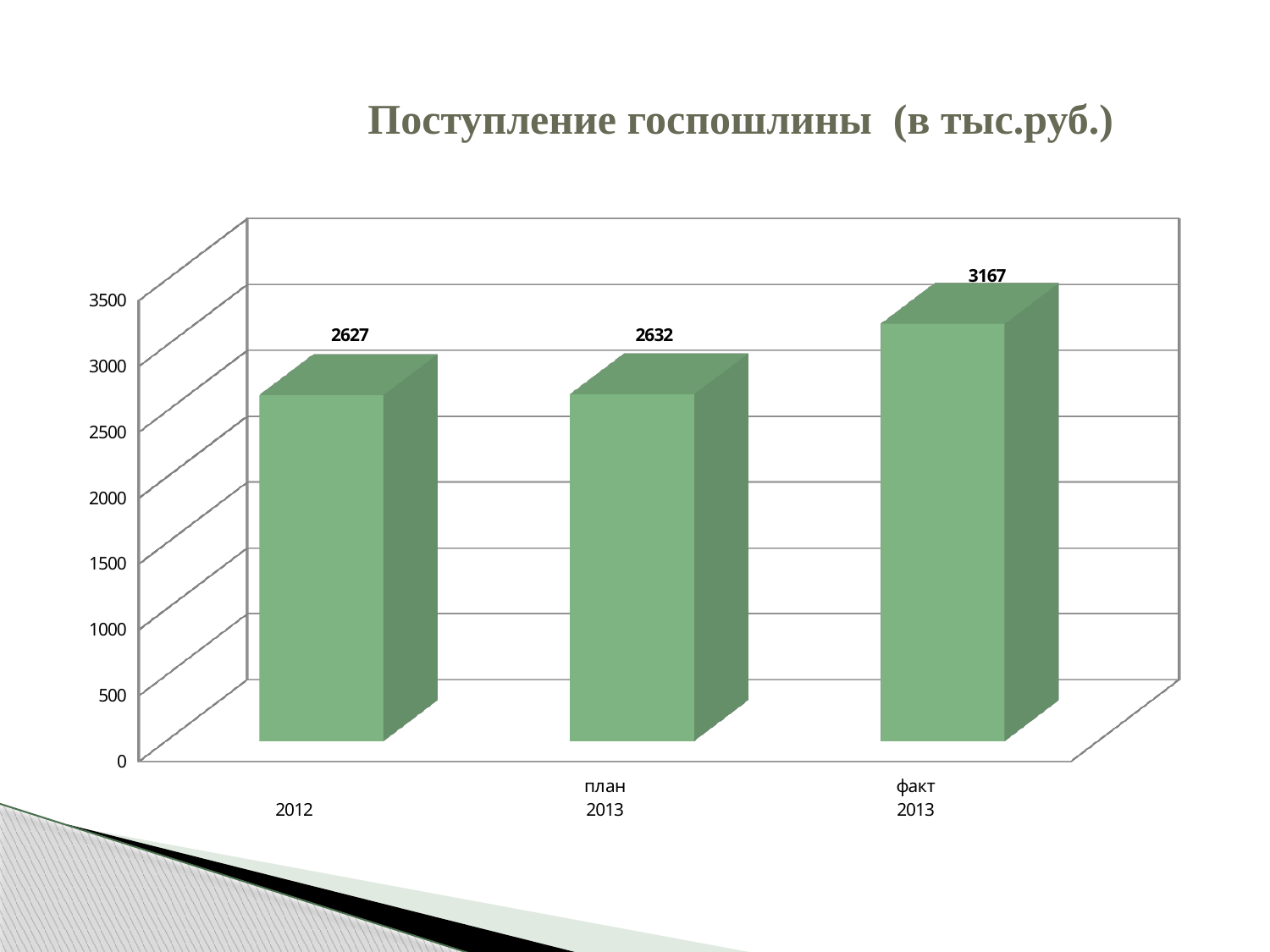
Is the value for 2012 greater or less than 3000? less What kind of chart is shown on the slide? bar chart What is the difference between факт 2013 and 2012? 540 What is the title of the chart? Поступление госпошлины (в тыс.руб.) What is the difference between факт 2013 and план 2013? 535 What is the value for факт 2013? 3167 Is the value for факт 2013 greater or less than 3000? greater Which category has the highest value? факт 2013 How many bars are shown in the chart? 3 What is the value for план 2013? 2632 What is the value for 2012? 2627 Which is larger, the value for факт 2013 or the value for 2012? факт 2013